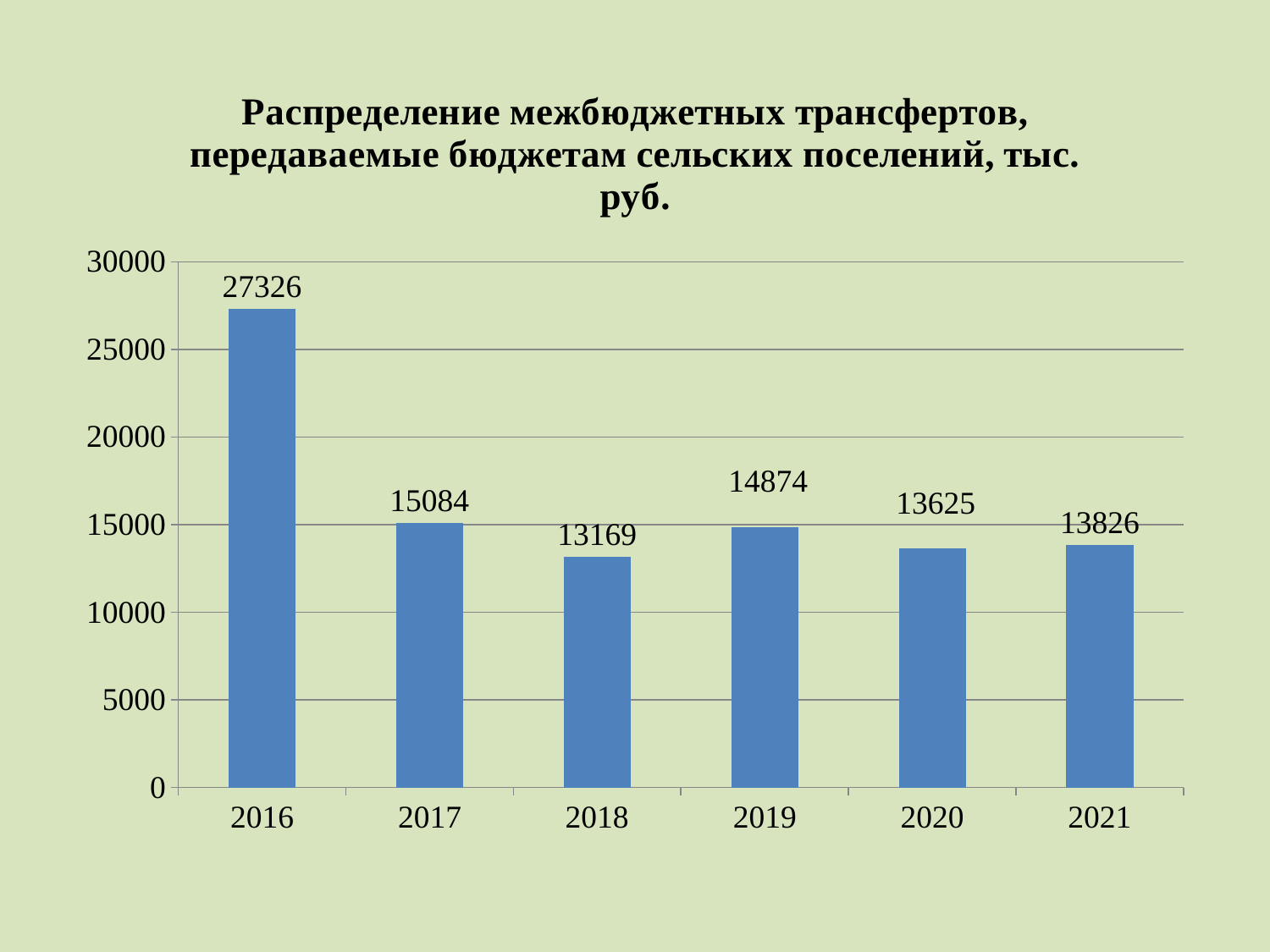
What is the value for 2021? 13826 Which year has the lowest value? 2018 What is the difference between the values for 2021 and 2020? 201 Which year has the highest value? 2016 What is the difference between the values for 2016 and 2017? 12242 What kind of chart is shown on the slide? bar chart Which is larger, the value for 2017 or the value for 2019? 2017 Is the value for 2018 greater or less than 15000? less What is the value for 2019? 14874 What is the value for 2016? 27326 How many years are shown on the x axis? 6 Does the value rise or fall from 2016 to 2017? fall